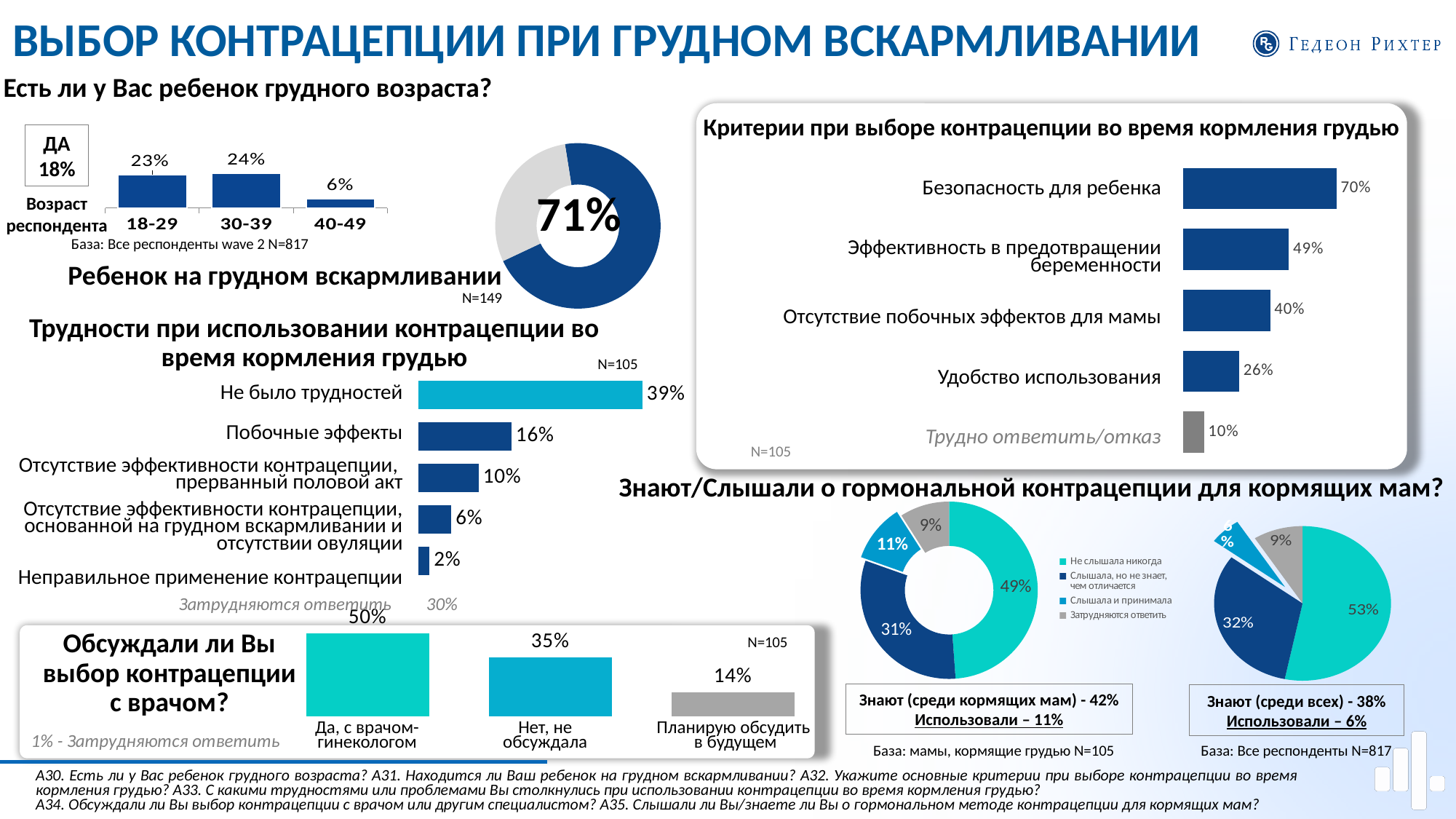
How many entries does the legend of the 'Знают/Слышали о гормональной контрацепции для кормящих мам?' charts list? 4 On the 'Критерии при выборе контрацепции во время кормления грудью' chart, which criterion has the lowest value? Трудно ответить/отказ On the 'Трудности при использовании контрацепции во время кормления грудью' chart, what is the value for 'Побочные эффекты'? 16% On the 'Трудности при использовании контрацепции во время кормления грудью' chart, which category has the highest value? Не было трудностей On the 'Критерии при выборе контрацепции во время кормления грудью' chart, what is the value for 'Безопасность для ребенка'? 70% On the 'Обсуждали ли Вы выбор контрацепции с врачом?' chart, how many categories are shown as bars? 3 On the 'Трудности при использовании контрацепции во время кормления грудью' chart, what is the value for 'Неправильное применение контрацепции'? 2% On the 'Обсуждали ли Вы выбор контрацепции с врачом?' chart, what is the value for 'Нет, не обсуждала'? 35% On the 'Возраст респондента' bar chart at the top left, what is the value for the 40-49 age group? 6% On the 'Критерии при выборе контрацепции во время кормления грудью' chart, what is the difference between 'Эффективность в предотвращении беременности' and 'Удобство использования'? 23% What percentage is shown in the centre of the 'Ребенок на грудном вскармливании' donut chart? 71% On the 'Возраст респондента' bar chart at the top left, which age group has the highest value? 30-39